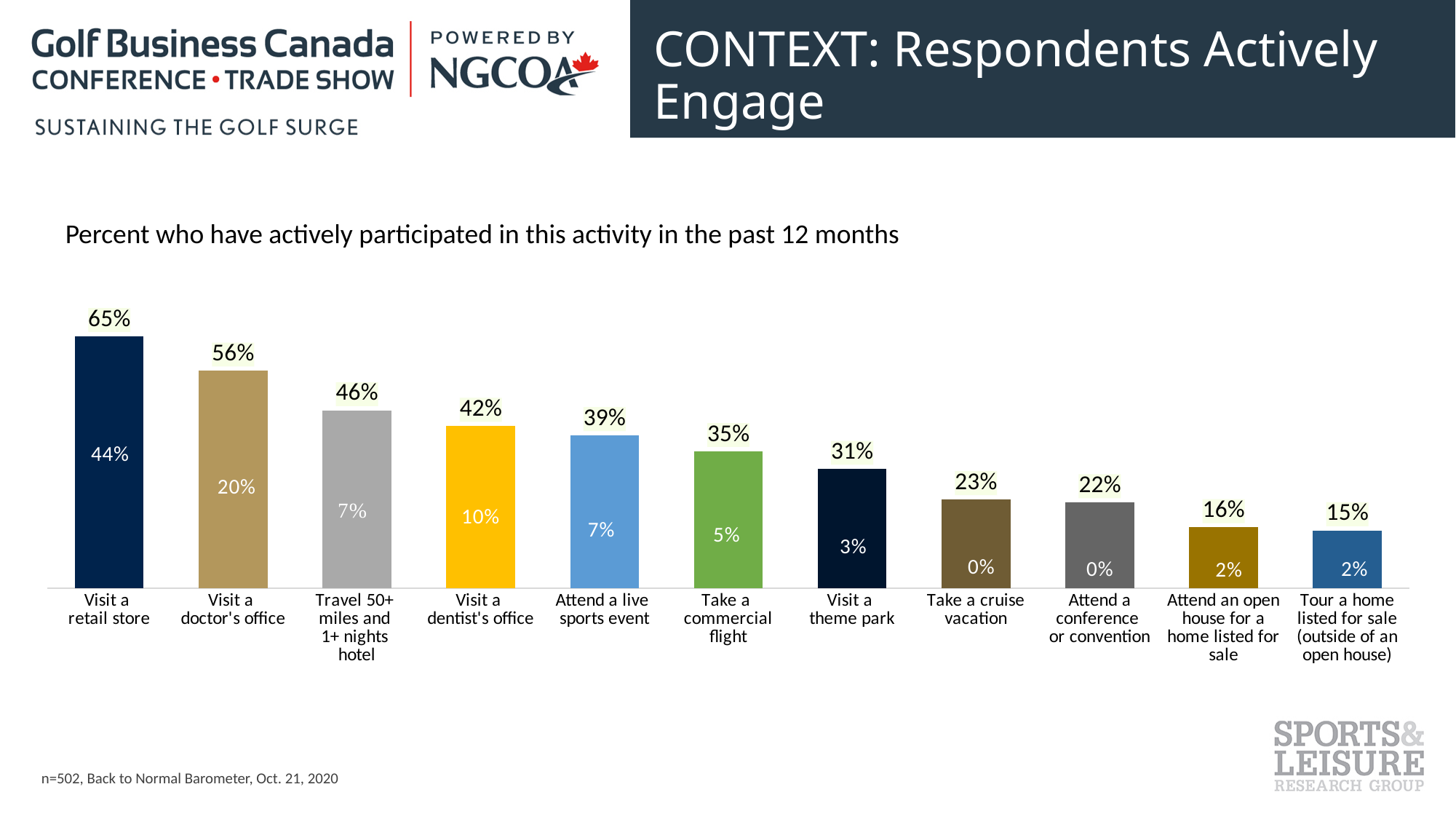
What is the difference between the values above the bars for 'Visit a retail store' and 'Visit a doctor's office'? 9% What value is shown above the bar for 'Take a cruise vacation'? 23% What percentage of respondents have visited a retail store in the past 12 months? 65% What value is printed inside the bar for 'Visit a dentist's office'? 10% How many activities (bars) are shown in the chart? 11 Which activity has the lowest percentage of participation? Tour a home listed for sale (outside of an open house) What is the subtitle describing what the chart measures? Percent who have actively participated in this activity in the past 12 months Do the values above the bars rise or fall from left to right across the chart? Fall Which has a higher value: 'Take a commercial flight' or 'Visit a theme park'? Take a commercial flight Which activity has the highest percentage of participation? Visit a retail store What type of chart is shown on the slide? Bar chart What value is shown above the bar for 'Attend a live sports event'? 39%